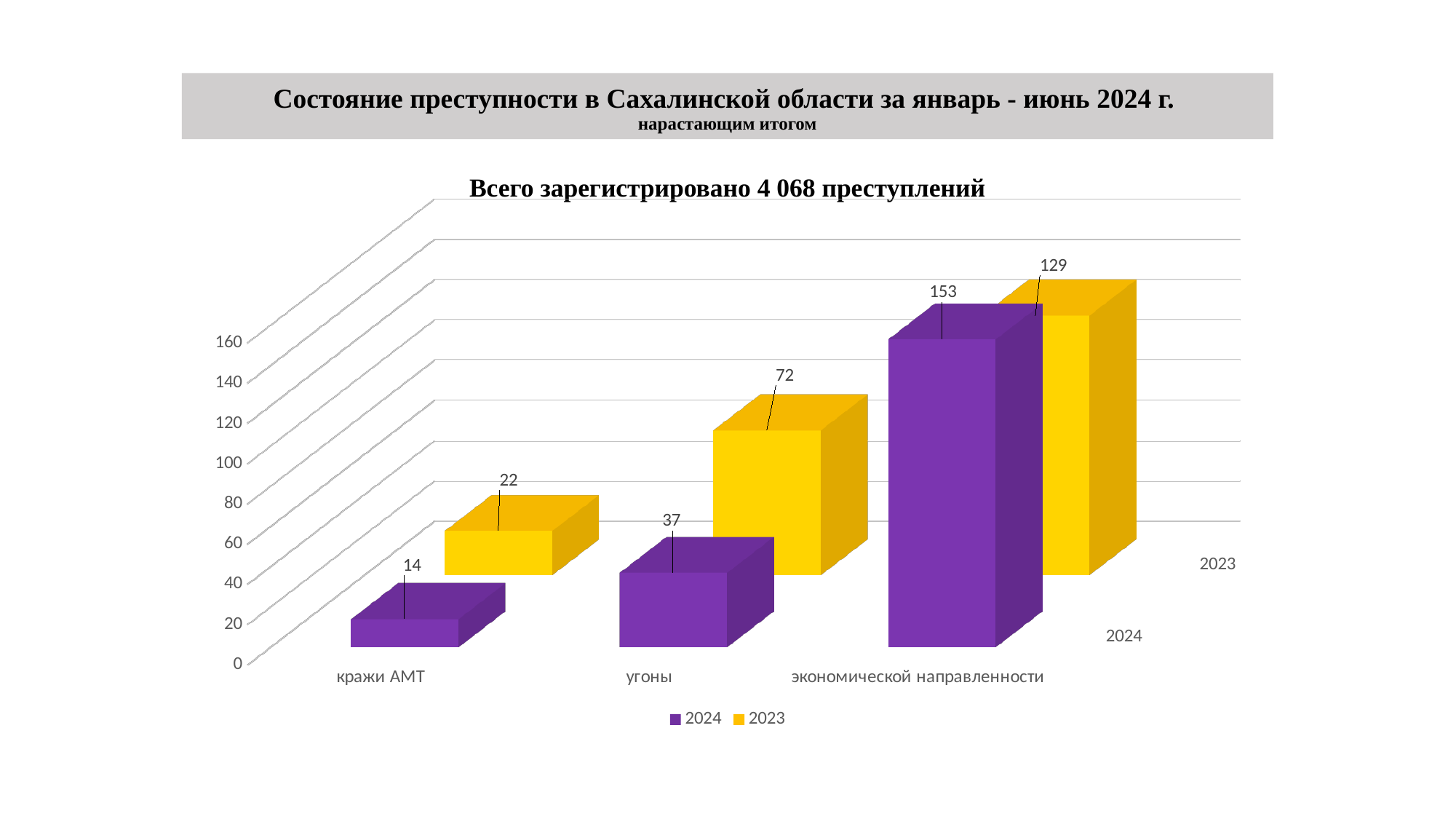
Which is larger for экономической направленности: the 2024 value or the 2023 value? 2024 What is the value for кражи АМТ in the 2024 series? 14 Which colour represents the 2023 series? yellow How many categories are shown on the x axis? 3 What kind of chart is shown on the slide? bar chart Which category has the highest value in the 2023 series? экономической направленности What is the value for угоны in the 2023 series? 72 What is the value for экономической направленности in the 2024 series? 153 How many series does the legend list? 2 What is the difference between the 2023 and 2024 values for угоны? 35 What is the chart's title? Всего зарегистрировано 4 068 преступлений Which category has the lowest value in the 2024 series? кражи АМТ